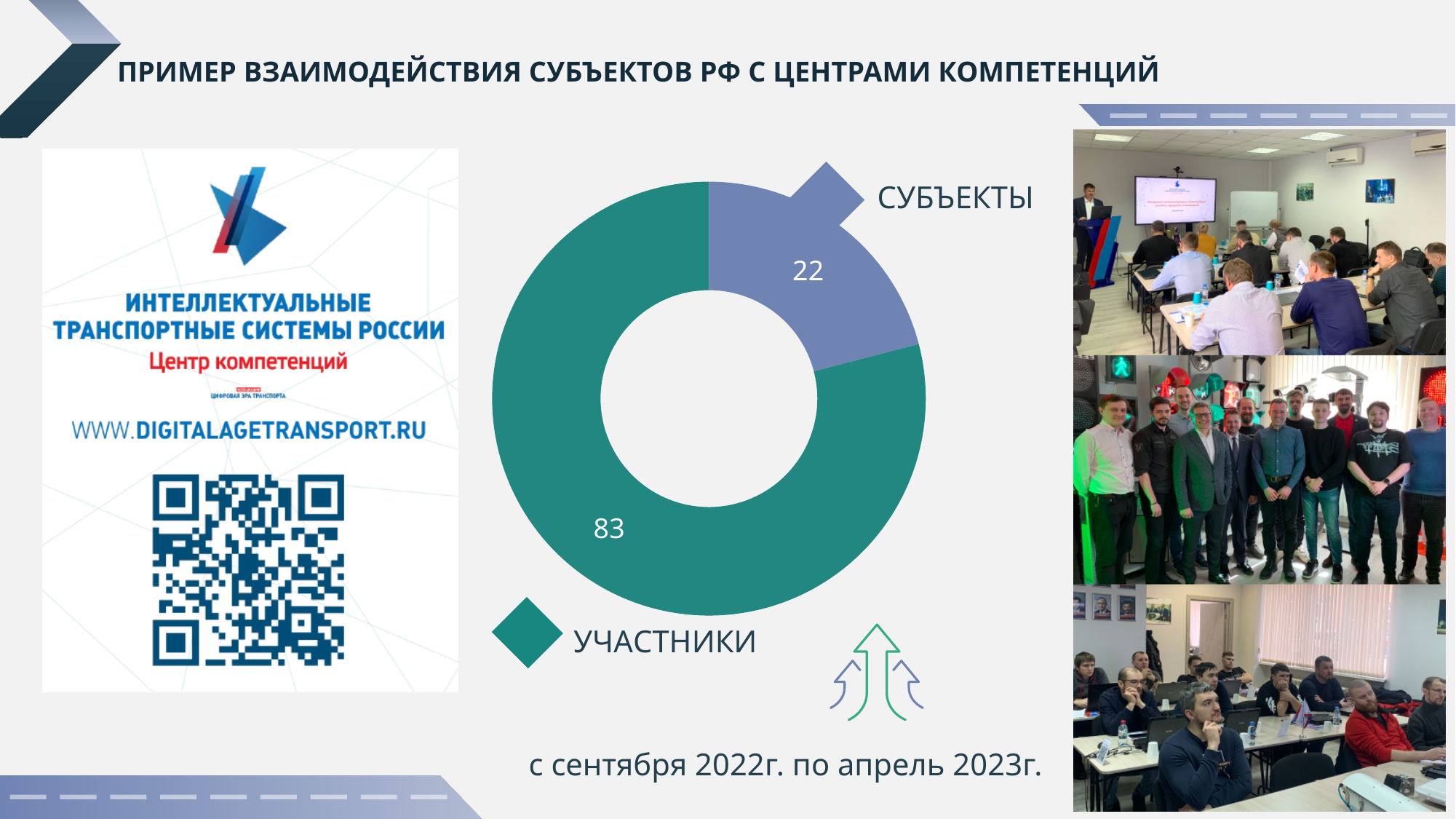
What value is shown for УЧАСТНИКИ in the doughnut chart? 83 How many categories are shown in the doughnut chart? 2 What colour is the УЧАСТНИКИ slice in the doughnut chart? Teal (green) Which category has the largest slice in the doughnut chart? УЧАСТНИКИ What is the difference between the values for УЧАСТНИКИ and СУБЪЕКТЫ? 61 Which category has the smallest slice in the doughnut chart? СУБЪЕКТЫ Which is larger, the value for СУБЪЕКТЫ or the value for УЧАСТНИКИ? УЧАСТНИКИ What time period is stated below the chart? с сентября 2022г. по апрель 2023г. What is the total of the two values shown in the doughnut chart? 105 What kind of chart is shown on the slide? Doughnut (pie) chart What value is shown for СУБЪЕКТЫ in the doughnut chart? 22